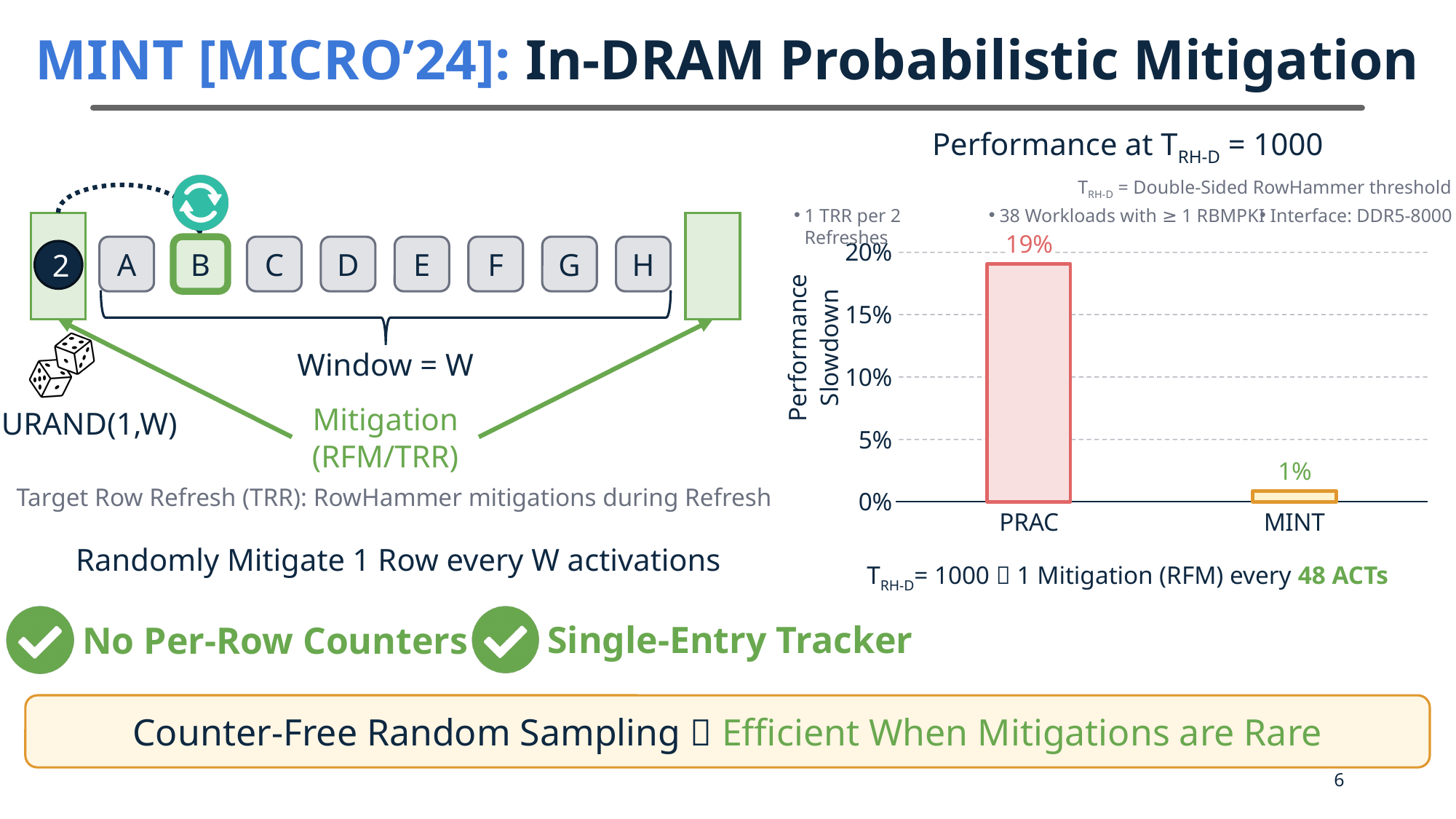
What is the title of the chart? Performance at T_RH-D = 1000 What is the performance slowdown for PRAC? 19% Which has a larger performance slowdown, PRAC or MINT? PRAC Is the performance slowdown for MINT greater or less than 5%? less How many categories are shown on the x axis of the chart? 2 What kind of chart is shown on the slide? bar chart Which category has the highest performance slowdown? PRAC What is the performance slowdown for MINT? 1% Is the performance slowdown for PRAC greater or less than 15%? greater What is the difference in performance slowdown between PRAC and MINT? 18% What is the label of the y axis of the chart? Performance Slowdown Which category has the lowest performance slowdown? MINT